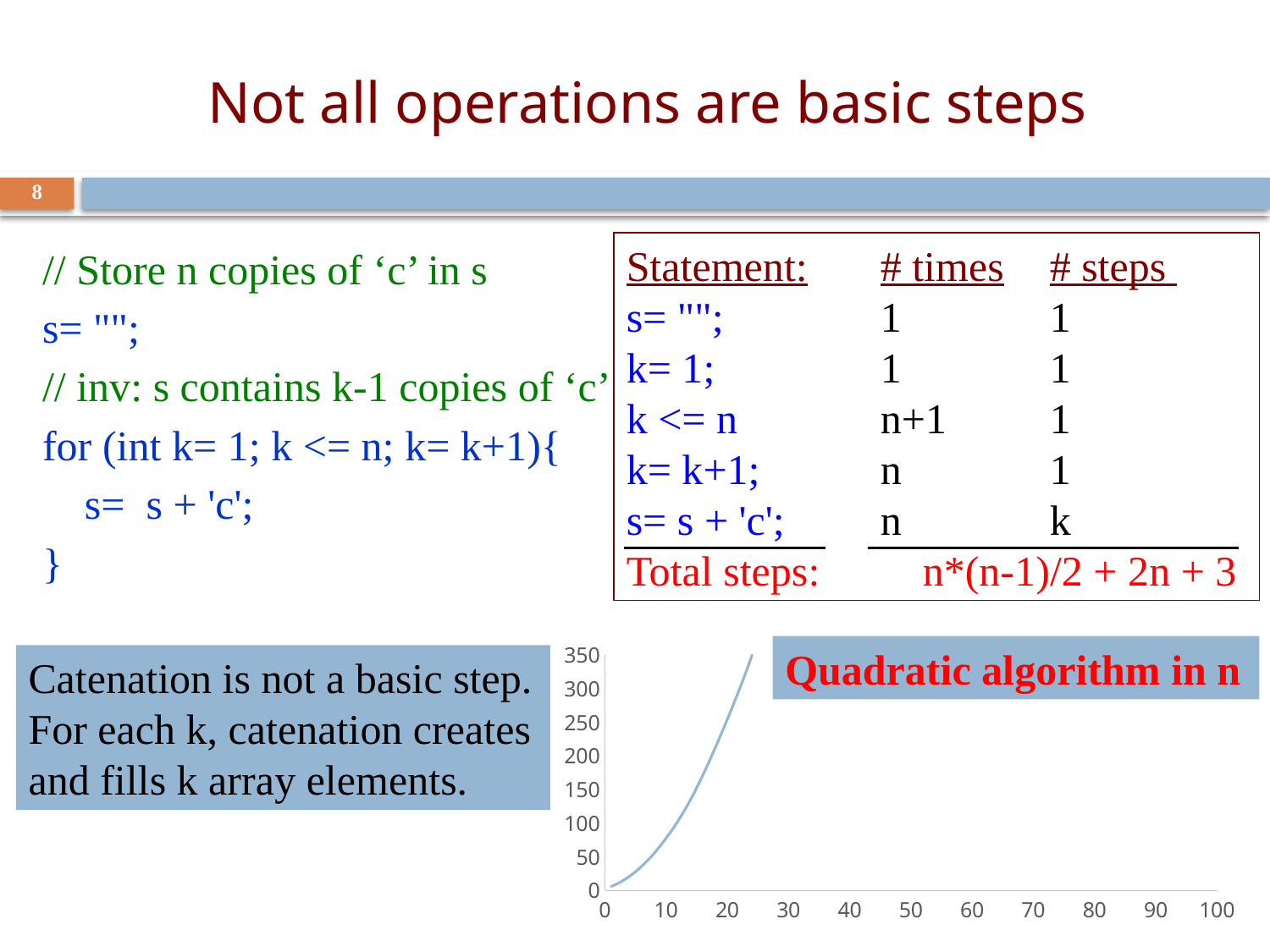
Does the plotted line rise or fall as the x-axis value increases? rises What is the highest value labelled on the chart's vertical axis? 350 Is the value of the plotted line at x = 20 greater or less than 150? greater What kind of chart is shown at the bottom of the slide? line chart Is the value of the plotted line at x = 10 greater or less than 100? less How many lines are plotted on the chart? 1 Does the plotted line curve upward more steeply as x increases, or does it flatten out? curves upward more steeply What is the highest value labelled on the chart's horizontal axis? 100 Is the value of the plotted line at x = 5 greater or less than 50? less